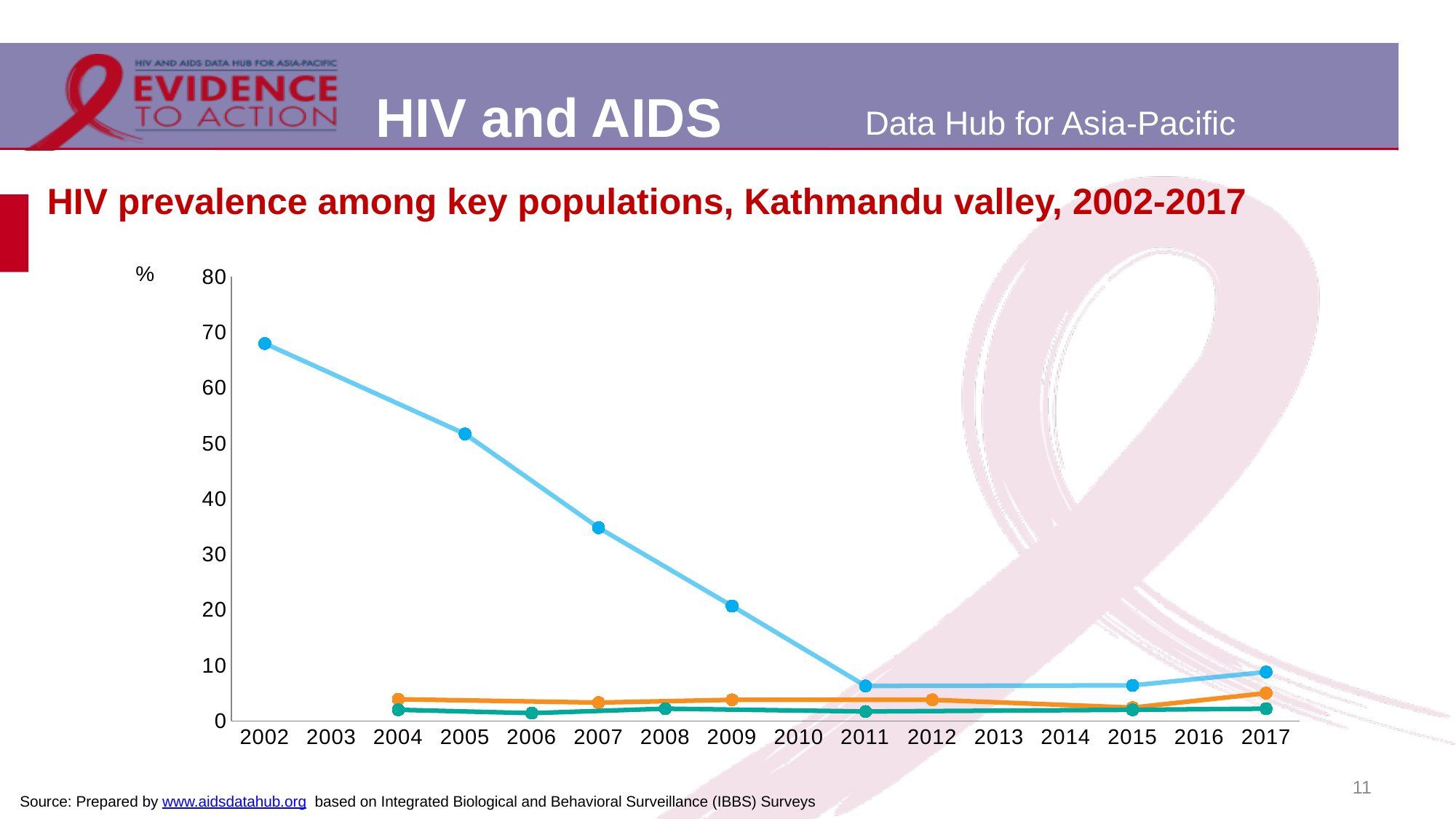
What unit is shown on the y axis of the chart? % How many years are labelled along the x axis of the chart? 16 What is the title of the chart? HIV prevalence among key populations, Kathmandu valley, 2002-2017 Does the blue line rise or fall between 2002 and 2011? fall Is the value of the blue line in 2002 greater or less than 60? greater Which is larger for the blue line, the value in 2002 or the value in 2005? 2002 Is the value of the blue line in 2009 greater or less than 30? less In which year does the blue line reach its highest value? 2002 How many lines are plotted on the chart? 3 Is the value of the blue line in 2011 greater or less than 10? less What kind of chart is shown on the slide? line chart